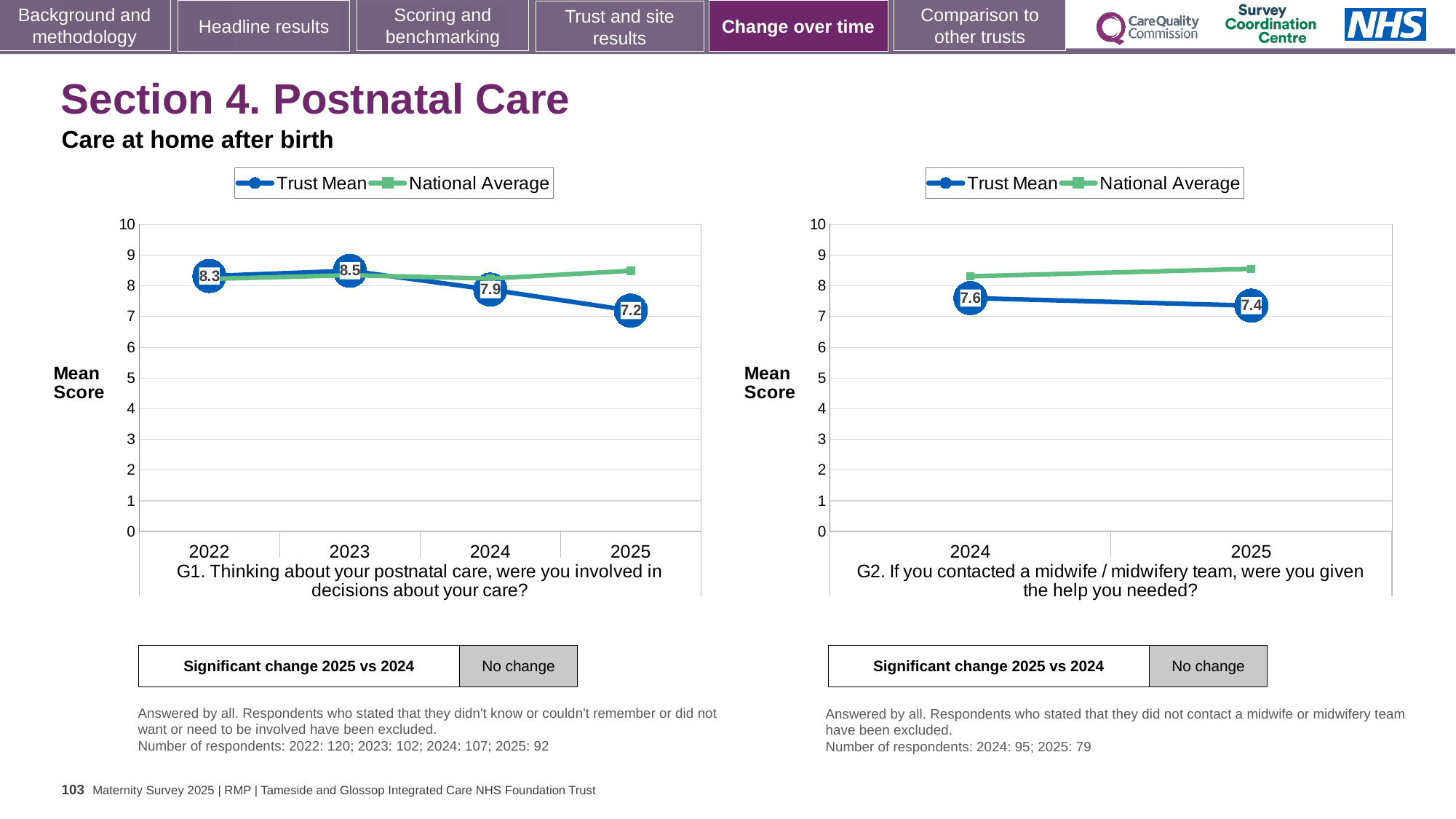
In the G1 chart (left), what is the Trust Mean score for 2023? 8.5 In the G1 chart (left), which year has the lowest Trust Mean score? 2025 How many series does the legend of the G2 chart (right) list? 2 In the G1 chart (left), is the National Average value for 2025 greater or less than 8? greater How many years are plotted on the x axis of the G1 chart (left)? 4 In the G2 chart (right), what is the difference between the Trust Mean scores for 2024 and 2025? 0.2 In the G1 chart (left), what is the Trust Mean score for 2025? 7.2 In the G2 chart (right), which is larger in 2025: the Trust Mean or the National Average? National Average In the G2 chart (right), what is the Trust Mean score for 2024? 7.6 In the G1 chart (left), what is the difference between the Trust Mean scores for 2023 and 2025? 1.3 In the G1 chart (left), which year has the highest Trust Mean score? 2023 What kind of chart is the G1 chart (left)? Line chart